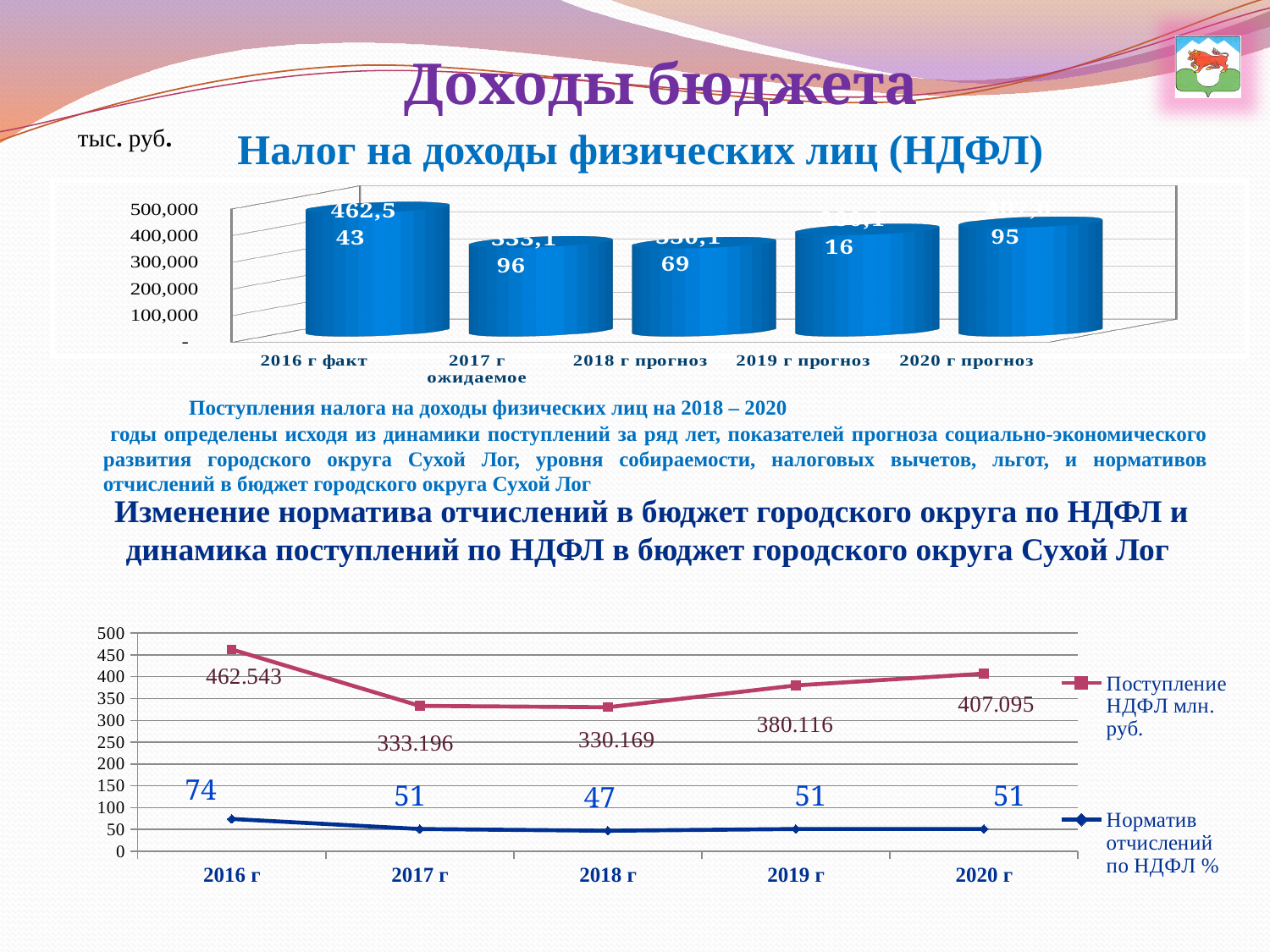
In the bottom line chart, by how much did Норматив отчислений по НДФЛ % fall from 2016 г to 2017 г? 23 In the bottom line chart, which is larger: Поступление НДФЛ млн. руб. in 2017 г or in 2019 г? 2019 г In the bottom line chart, which year has the highest value of Поступление НДФЛ млн. руб.? 2016 г In the bottom line chart, what is the difference between Поступление НДФЛ млн. руб. in 2020 г and in 2019 г? 26.979 How many years are plotted on the x axis of the bottom line chart? 5 How many series does the legend of the bottom line chart list? 2 What kind of chart is the top chart titled 'Налог на доходы физических лиц (НДФЛ)'? bar chart In the bottom line chart, does Поступление НДФЛ млн. руб. rise or fall from 2018 г to 2020 г? rise In the bottom line chart, which year has the lowest value of Норматив отчислений по НДФЛ %? 2018 г In the top bar chart, is the value for 2016 г факт greater or less than 400,000? greater In the bottom line chart, what is the value of Норматив отчислений по НДФЛ % for 2016 г? 74 In the bottom line chart, what is the value of Поступление НДФЛ млн. руб. for 2018 г? 330.169